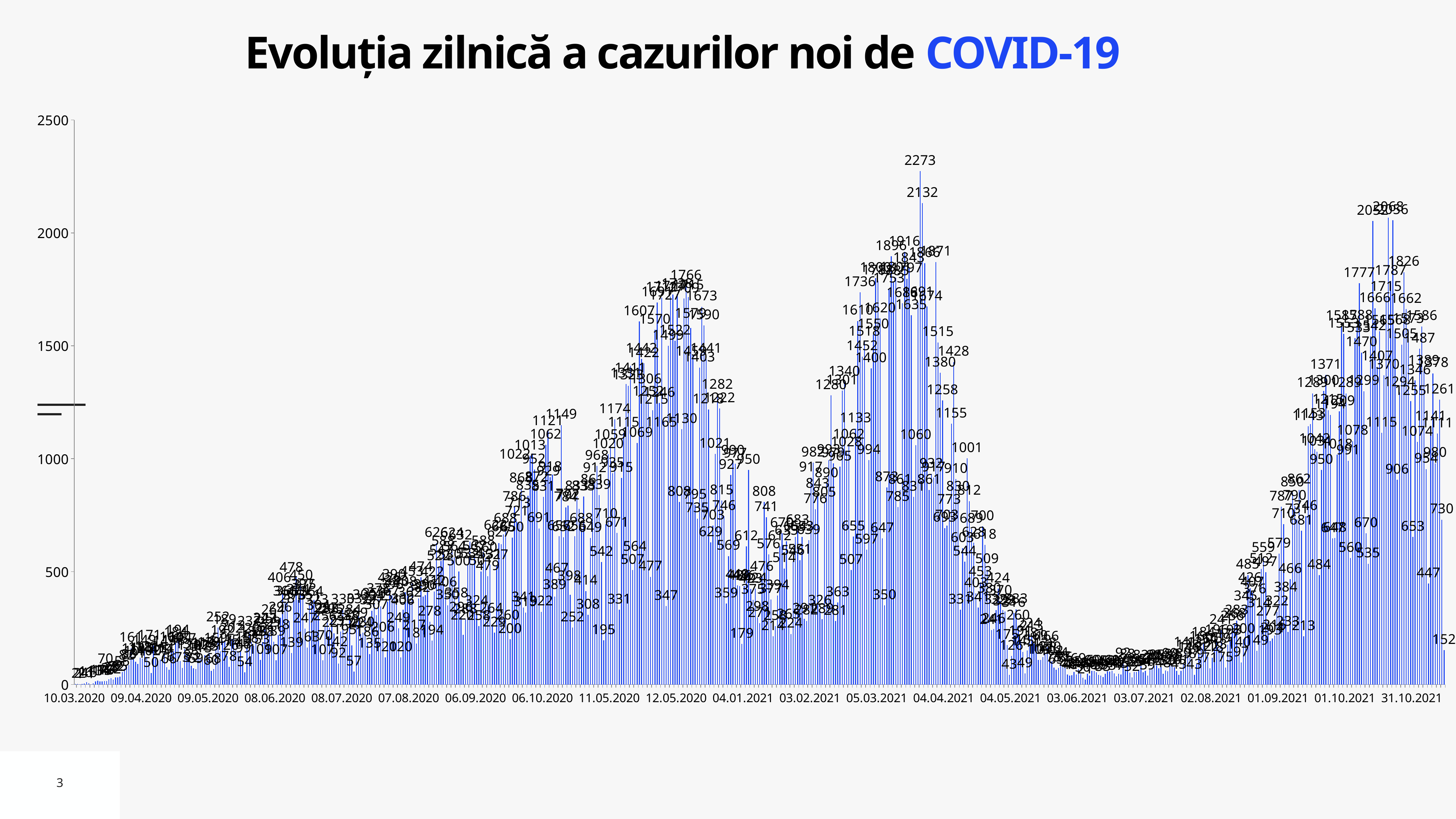
What is the value labelled on the last bar at the far right of the chart? 152 Do the values rise or fall between 04.04.2021 and 03.06.2021? fall What is the first date shown on the horizontal axis? 10.03.2020 Which is larger, the peak labelled 2273 or the peak labelled 1766? 2273 What is the highest daily value labelled on the chart? 2273 Is the peak value of the chart greater or less than 2000? greater What is the title of the chart? Evoluția zilnică a cazurilor noi de COVID-19 What kind of chart is shown on the slide? bar chart What is the last date shown on the horizontal axis? 31.10.2021 What is the difference between the two highest labelled values, 2273 and 2132? 141 Are the values around 03.06.2021 greater or less than 500? less What is the highest value shown on the vertical axis? 2500